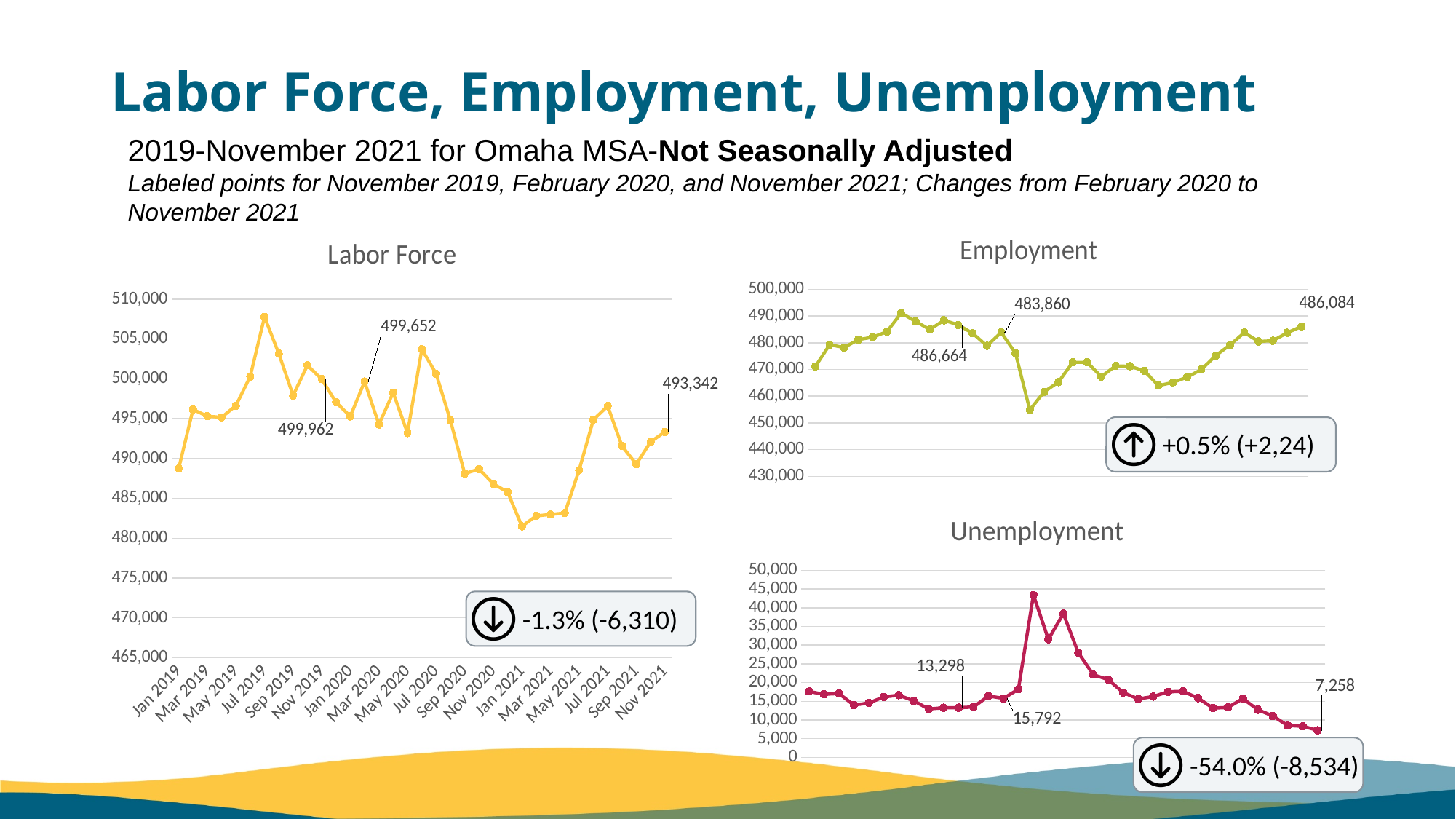
What kind of chart is the Unemployment chart? line chart On the Labor Force chart, what is the difference between the November 2019 value and the February 2020 value? 310 On the Labor Force chart, is the value for January 2019 greater or less than 490,000? less On the Labor Force chart, what is the labeled value for November 2019? 499,962 On the Employment chart, which is larger: the February 2020 value or the November 2021 value? November 2021 On the Employment chart, what is the labeled value for February 2020? 483,860 On the Labor Force chart, what is the labeled value for November 2021? 493,342 On the Unemployment chart, what is the labeled value for February 2020? 15,792 What change from February 2020 to November 2021 is shown in the callout on the Labor Force chart? -1.3% (-6,310) On the Unemployment chart, what is the labeled value for November 2021? 7,258 On the Unemployment chart, what is the difference between the February 2020 value and the November 2021 value? 8,534 On the Employment chart, what is the labeled value for November 2021? 486,084